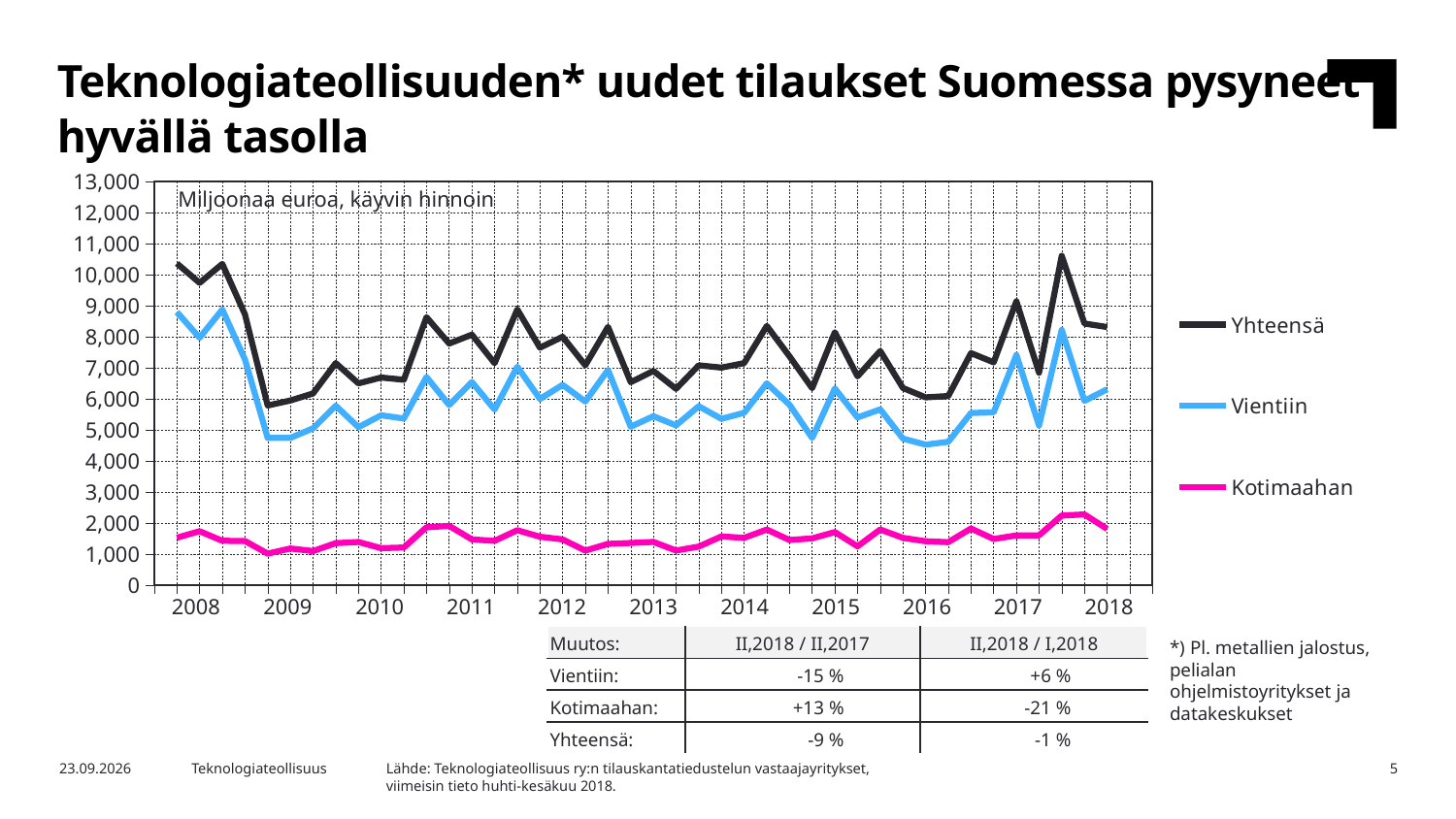
What kind of chart is shown on the slide? line chart What unit label is printed inside the chart's plot area? Miljoonaa euroa, käyvin hinnoin Which series has the highest values across the whole chart? Yhteensä How many series does the chart's legend list? 3 What are the series names listed in the chart's legend? Yhteensä, Vientiin, Kotimaahan At 2015, which is larger: the value for Vientiin or the value for Kotimaahan? Vientiin Is the value for Vientiin at 2009 greater or less than 6,000? less Which series has the lowest values across the whole chart? Kotimaahan Is the value for Kotimaahan at 2018 greater or less than 3,000? less How many year labels are shown on the x axis? 11 Does the Yhteensä line rise or fall between 2008 and 2009? fall Is the value for Yhteensä at the start of 2008 greater or less than 9,000? greater